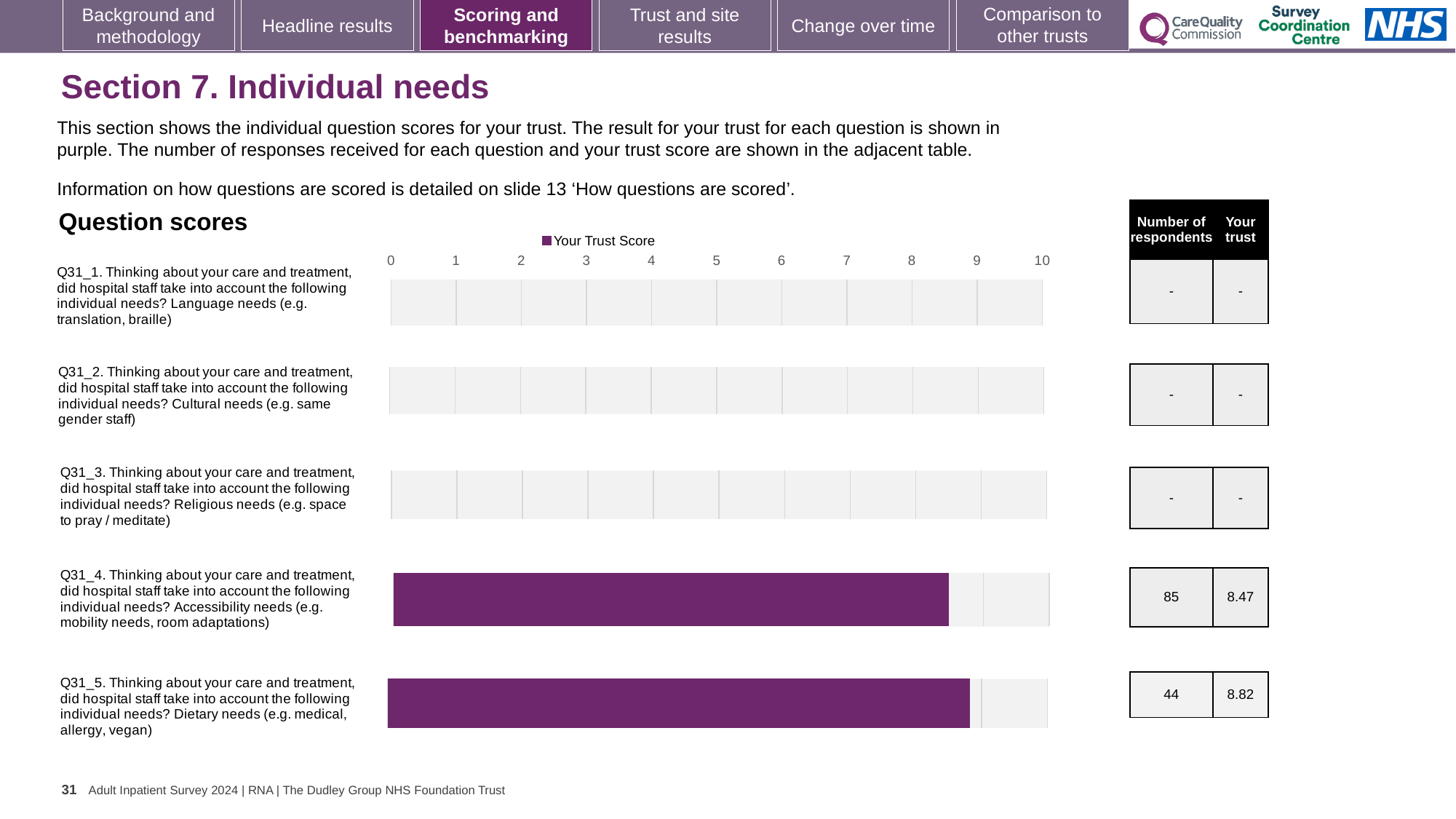
How many respondents answered Q31_4 (Accessibility needs)? 85 What is the trust score for Q31_4 (Accessibility needs)? 8.47 Is the trust score for Q31_5 (Dietary needs) greater or less than 9? less Which question has the higher trust score, Q31_4 (Accessibility needs) or Q31_5 (Dietary needs)? Q31_5 (Dietary needs) Is the trust score for Q31_4 (Accessibility needs) greater or less than 8? greater What kind of chart is used to show the question scores? Bar chart What is the name of the series shown in the chart legend? Your Trust Score How many series does the chart legend list? 1 What is the trust score for Q31_5 (Dietary needs)? 8.82 What is the difference between the trust scores for Q31_5 (Dietary needs) and Q31_4 (Accessibility needs)? 0.35 How many respondents answered Q31_5 (Dietary needs)? 44 How many questions are listed in the Question scores chart? 5